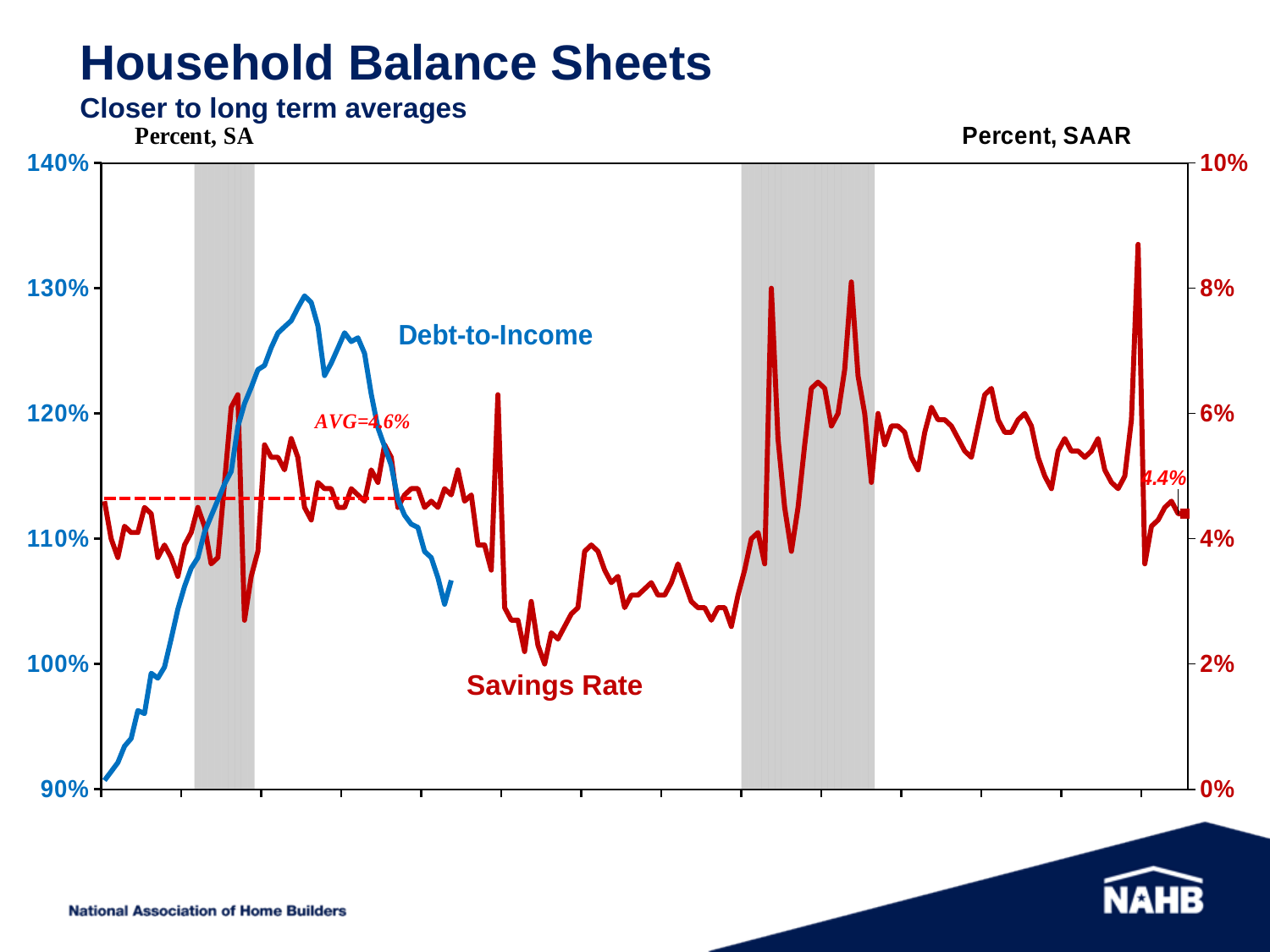
Is the peak of the Debt-to-Income line greater or less than 120%? greater Is the highest spike of the Savings Rate line greater or less than 8%? greater What kind of chart is shown on the slide? line chart What is the most recent value labeled for the Savings Rate? 4.4% Which is larger, the Savings Rate long-term average or the latest Savings Rate value of 4.4%? the long-term average (4.6%) Does the Debt-to-Income line rise or fall over its final portion after reaching its peak? fall How many data series are plotted on the chart? 4 Is the lowest point of the Savings Rate line greater or less than 4%? less What is the title of the slide containing the chart? Household Balance Sheets What long-term average is labeled for the Savings Rate? AVG=4.6% By how much does the latest Savings Rate value (4.4%) fall below the labeled average (4.6%)? 0.2% Which series is drawn in blue? Debt-to-Income